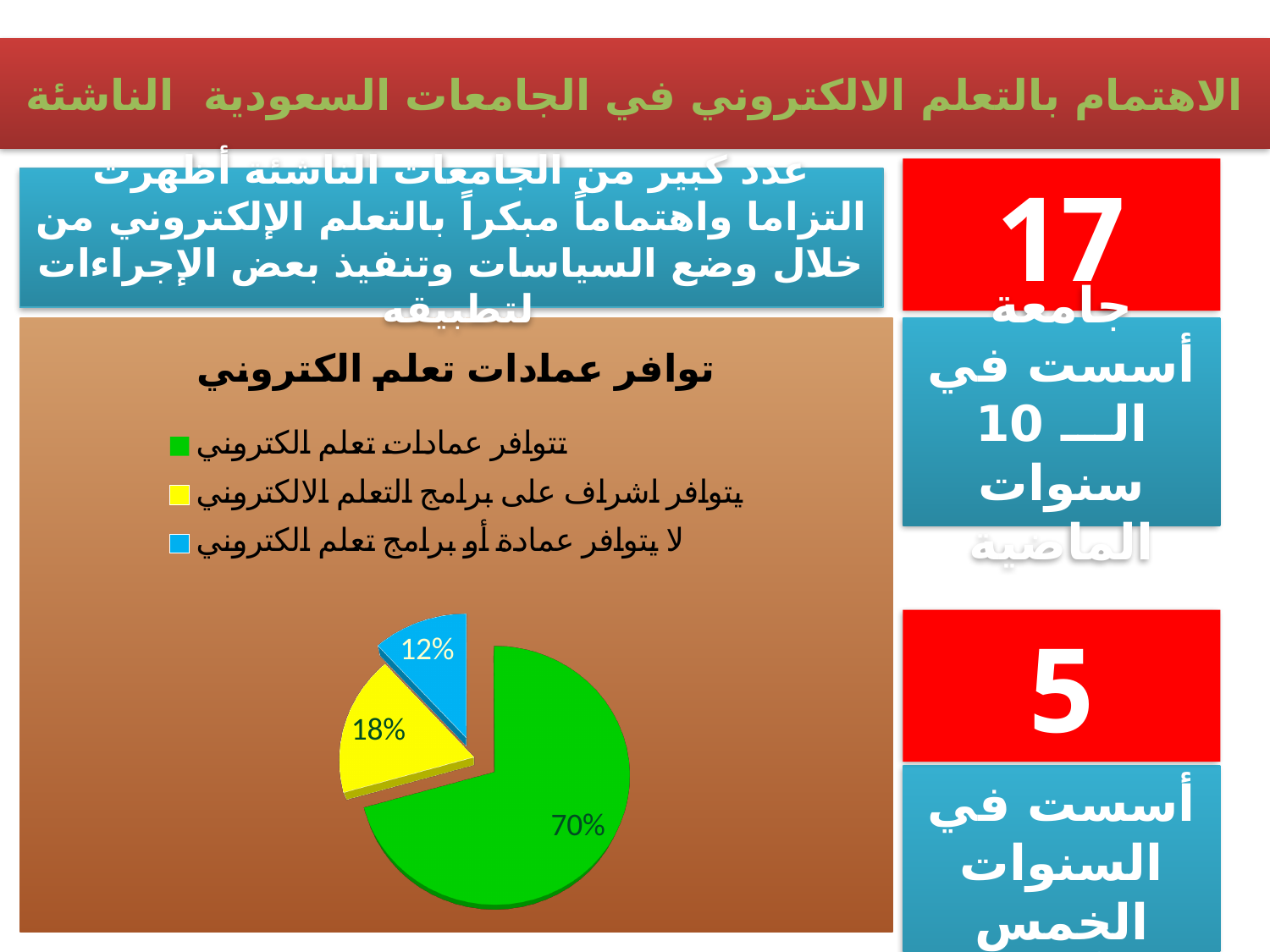
What colour is the slice representing 12%? blue Which category has the smallest slice of the pie? لا يتوافر عمادة أو برامج تعلم الكتروني Which category has the largest slice of the pie? تتوافر عمادات تعلم الكتروني Which is larger: the slice for "يتوافر اشراف على برامج التعلم الالكتروني" or the slice for "لا يتوافر عمادة أو برامج تعلم الكتروني"? يتوافر اشراف على برامج التعلم الالكتروني What share of the pie is labelled "تتوافر عمادات تعلم الكتروني"? 70% What is the difference in percentage points between the green slice (70%) and the yellow slice (18%)? 52 How many entries does the chart legend list? 3 What kind of chart is shown on the slide? pie chart What is the title of the chart? توافر عمادات تعلم الكتروني How many slices does the pie chart have? 3 What share of the pie is labelled "يتوافر اشراف على برامج التعلم الالكتروني"? 18% What share of the pie is labelled "لا يتوافر عمادة أو برامج تعلم الكتروني"? 12%